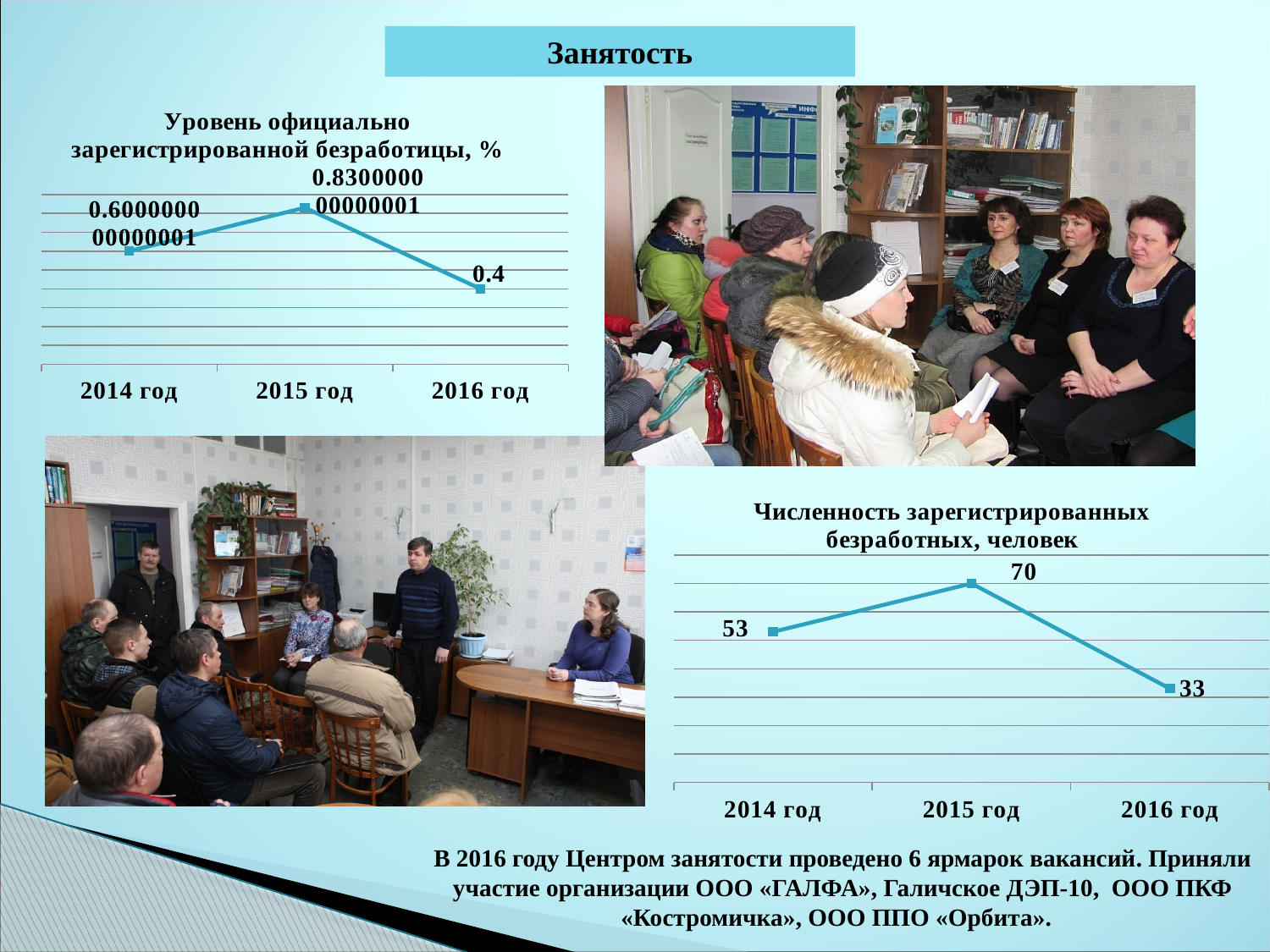
What kind of chart is 'Численность зарегистрированных безработных, человек'? Line chart On the chart 'Уровень официально зарегистрированной безработицы, %', what is the value for 2016 год? 0.4 On the chart 'Численность зарегистрированных безработных, человек', what is the difference between the values for 2014 год and 2016 год? 20 How many years are plotted on the chart 'Уровень официально зарегистрированной безработицы, %'? 3 On the chart 'Уровень официально зарегистрированной безработицы, %', which is larger, the value for 2014 год or 2016 год? 2014 год On the chart 'Численность зарегистрированных безработных, человек', which year has the lowest value? 2016 год On the chart 'Численность зарегистрированных безработных, человек', which year has the highest value? 2015 год On the chart 'Численность зарегистрированных безработных, человек', what is the value for 2016 год? 33 On the chart 'Численность зарегистрированных безработных, человек', what is the value for 2015 год? 70 On the chart 'Численность зарегистрированных безработных, человек', what is the difference between the values for 2015 год and 2016 год? 37 On the chart 'Численность зарегистрированных безработных, человек', what is the value for 2014 год? 53 On the chart 'Уровень официально зарегистрированной безработицы, %', which year has the highest value? 2015 год